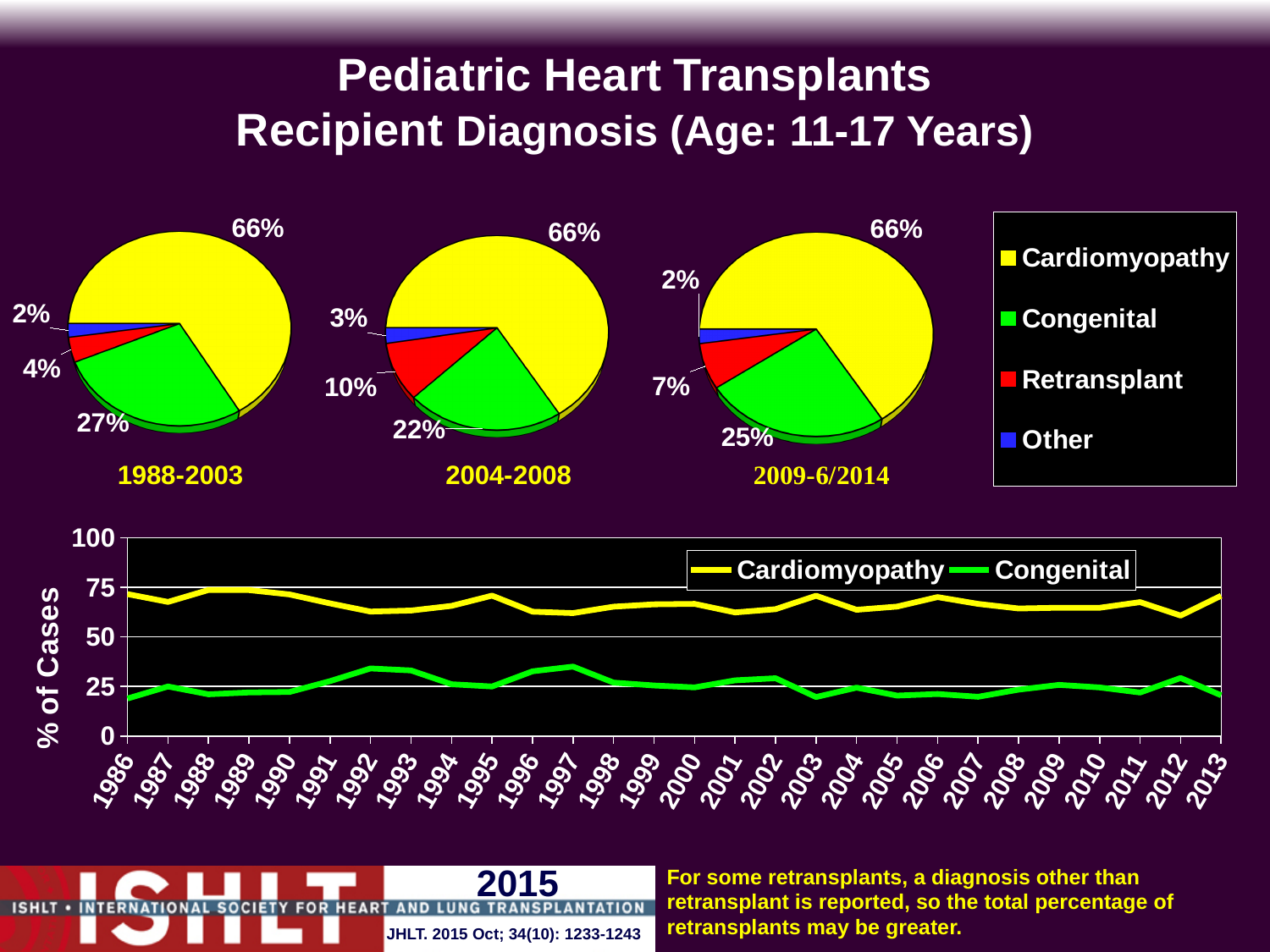
How many series does the legend of the bottom line chart list? 2 In the 1988-2003 pie chart, which diagnosis has the largest share? Cardiomyopathy Is the Retransplant share larger in the 1988-2003 pie chart or the 2004-2008 pie chart? 2004-2008 In the 2009-6/2014 pie chart, what is the difference between the Congenital and Retransplant shares? 18% In the 2009-6/2014 pie chart, what percentage is Congenital? 25% What type of chart is the bottom chart showing % of Cases from 1986 to 2013? Line chart In the 1988-2003 pie chart, what percentage is Cardiomyopathy? 66% In the 2004-2008 pie chart, what percentage is Retransplant? 10% In the bottom line chart, is the Congenital value for 1997 greater or less than 25? greater How many diagnosis categories does the pie chart legend list? 4 In the 2004-2008 pie chart, which diagnosis has the smallest share? Other In the bottom line chart, is the Cardiomyopathy value for 1988 greater or less than 50? greater